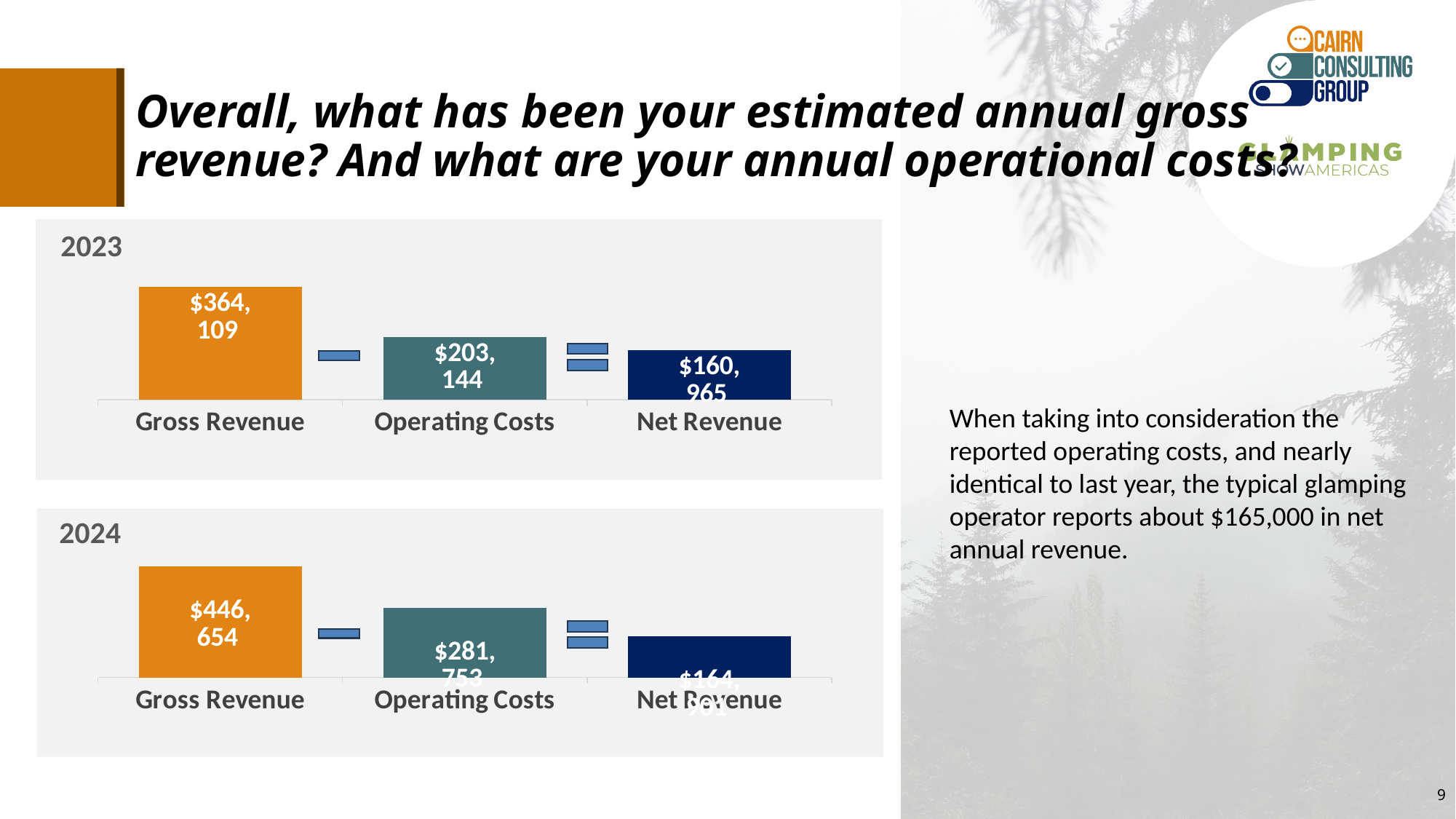
In the 2023 chart, what is the difference between Gross Revenue and Operating Costs? $160,965 Is Gross Revenue larger in the 2023 chart or the 2024 chart? 2024 In the 2024 chart, what is the value for Operating Costs? $281,753 In the 2023 chart, which category has the highest value? Gross Revenue How many categories are shown in the 2024 chart? 3 In the 2023 chart, what is the value for Gross Revenue? $364,109 In the 2024 chart, what is the value for Gross Revenue? $446,654 What kind of chart is the 2023 chart? Bar chart In the 2023 chart, what is the value for Net Revenue? $160,965 In the 2023 chart, what is the value for Operating Costs? $203,144 In the 2024 chart, what is the difference between Gross Revenue and Operating Costs? $164,901 In the 2024 chart, which category has the lowest value? Net Revenue